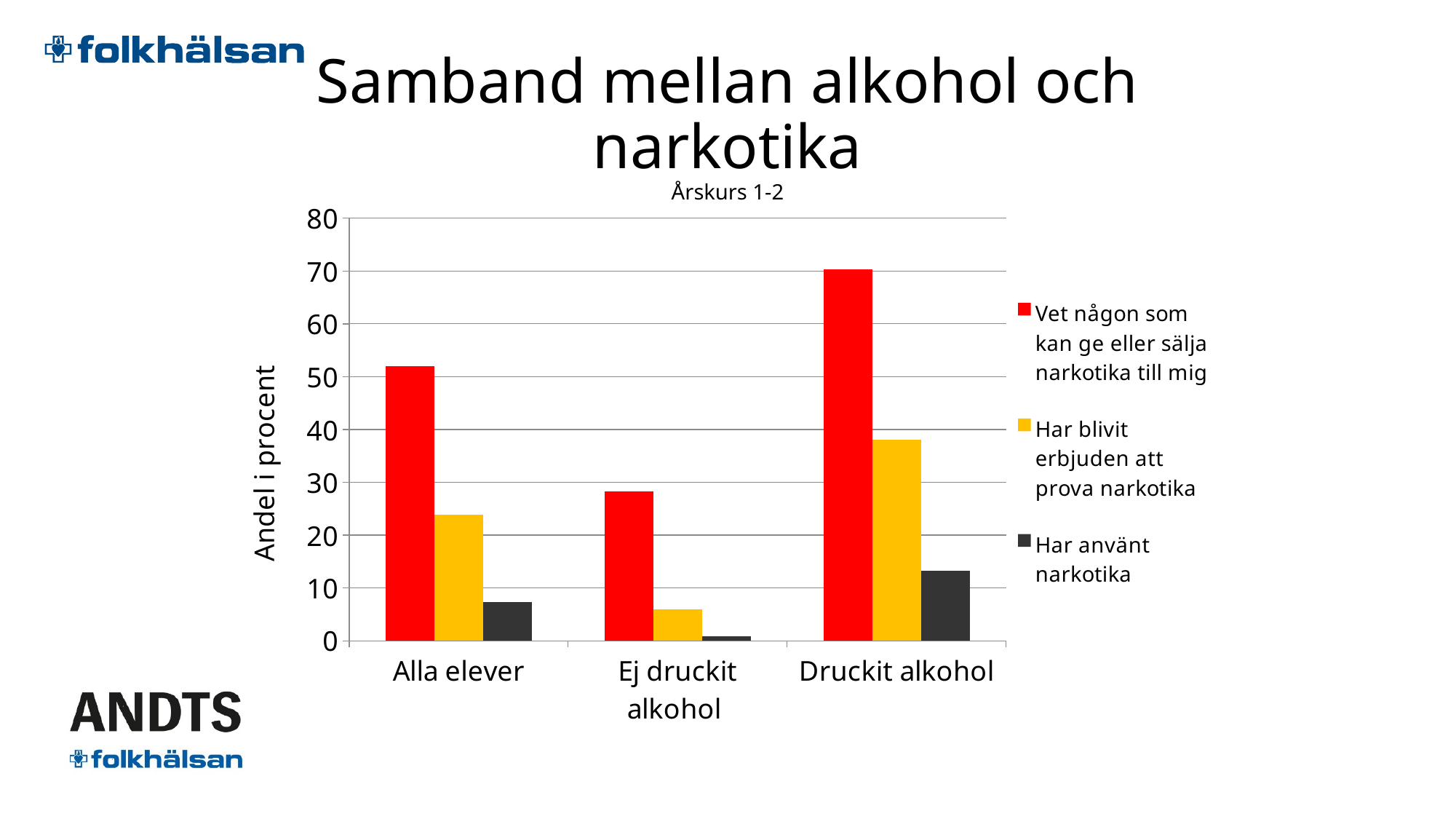
Which category has the lowest value for 'Har använt narkotika'? Ej druckit alkohol How many categories are shown on the x axis? 3 Is the value for 'Har använt narkotika' in the 'Alla elever' category greater or less than 10? less Is the value for 'Har blivit erbjuden att prova narkotika' in the 'Ej druckit alkohol' category greater or less than 10? less What is the label of the y axis? Andel i procent What colour are the bars for 'Har använt narkotika'? dark grey How many series does the legend list? 3 Which is larger: 'Har blivit erbjuden att prova narkotika' for 'Alla elever' or for 'Druckit alkohol'? Druckit alkohol Is the value for 'Vet någon som kan ge eller sälja narkotika till mig' in the 'Druckit alkohol' category greater or less than 60? greater Which category has the highest value for 'Vet någon som kan ge eller sälja narkotika till mig'? Druckit alkohol What kind of chart is shown on the slide? bar chart